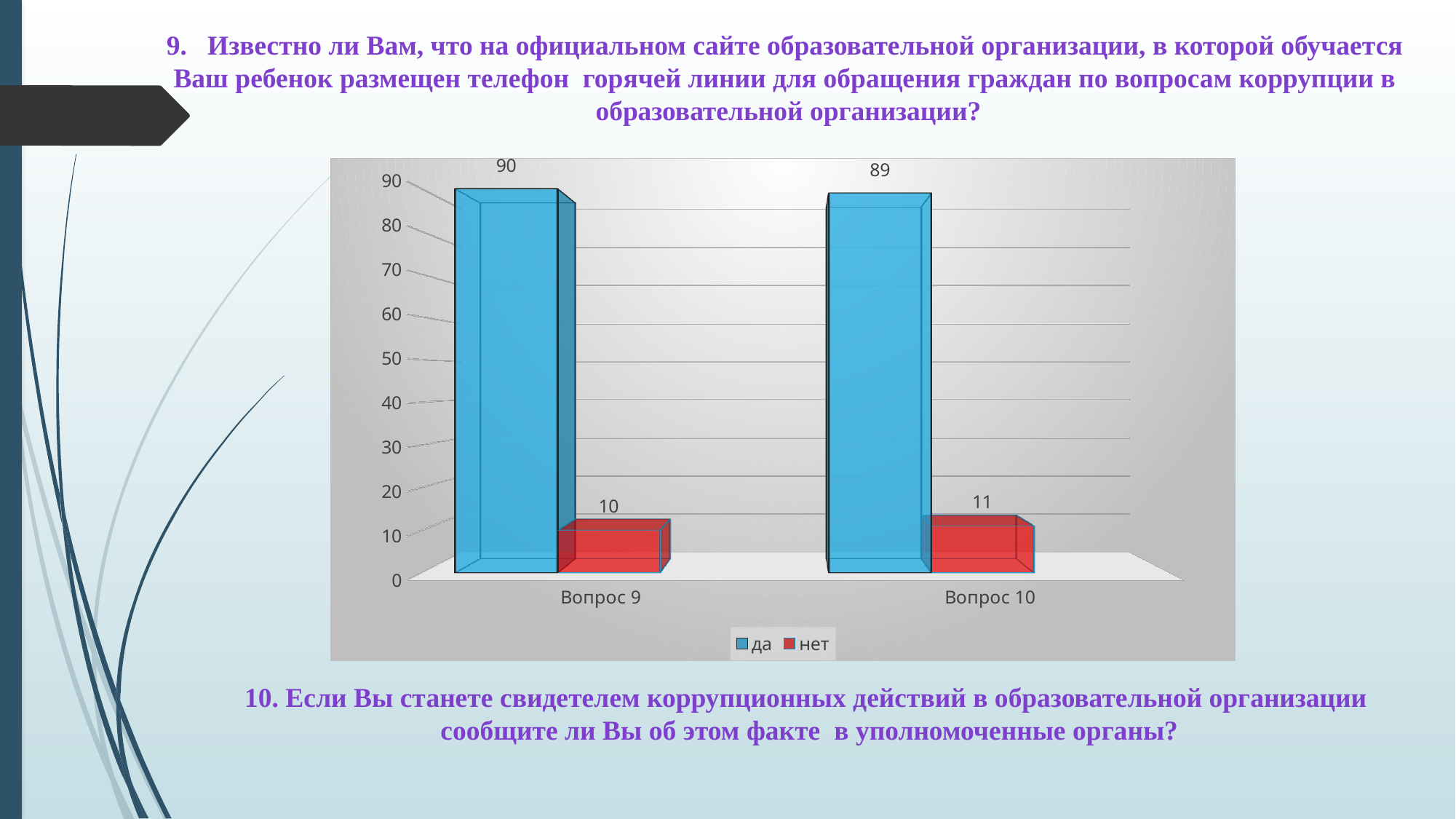
Which category has the lowest value for "нет"? Вопрос 9 Which is larger for Вопрос 10, "да" or "нет"? да How many series does the legend list? 2 What kind of chart is shown on the slide? bar chart What is the value for "да" for Вопрос 10? 89 What is the difference between the "да" and "нет" values for Вопрос 10? 78 What is the value for "нет" for Вопрос 10? 11 How many categories are shown on the x axis? 2 Which category has the highest value for "да"? Вопрос 9 What is the difference between the "да" and "нет" values for Вопрос 9? 80 What is the value for "да" for Вопрос 9? 90 What is the value for "нет" for Вопрос 9? 10